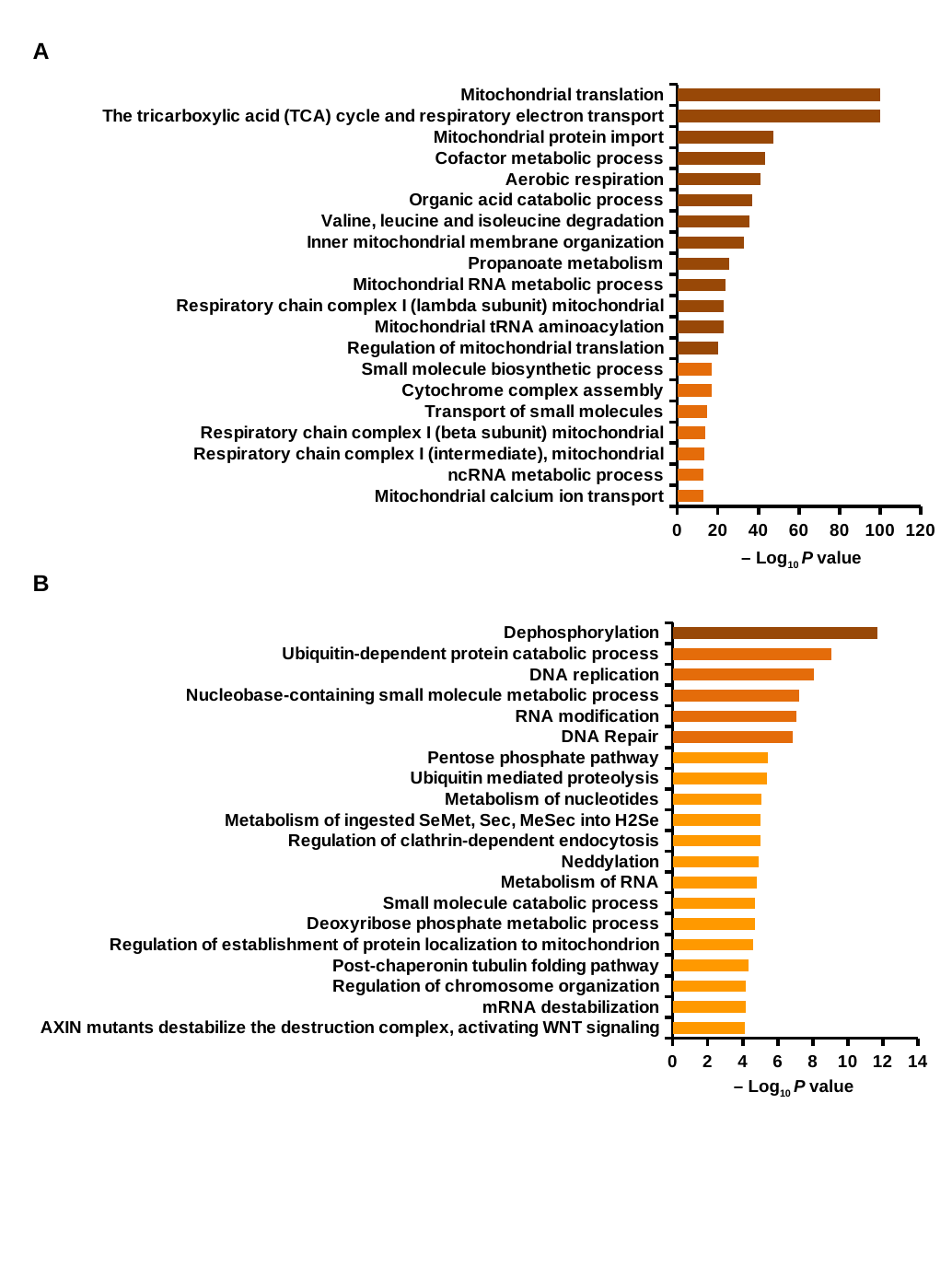
In chart A, is the value for Mitochondrial protein import greater or less than 40? greater In chart B, is the value for Dephosphorylation greater or less than 10? greater In chart A, is the value for Mitochondrial translation greater or less than 80? greater In chart B, how many categories are plotted? 20 In chart A, how many categories are plotted? 20 What is the x-axis title of chart A? – Log10 P value What kind of chart is chart A? bar chart In chart A, which is larger, the value for Mitochondrial protein import or the value for Propanoate metabolism? Mitochondrial protein import In chart B, which category has the highest value? Dephosphorylation In chart B, which is larger, the value for DNA Repair or the value for Pentose phosphate pathway? DNA Repair